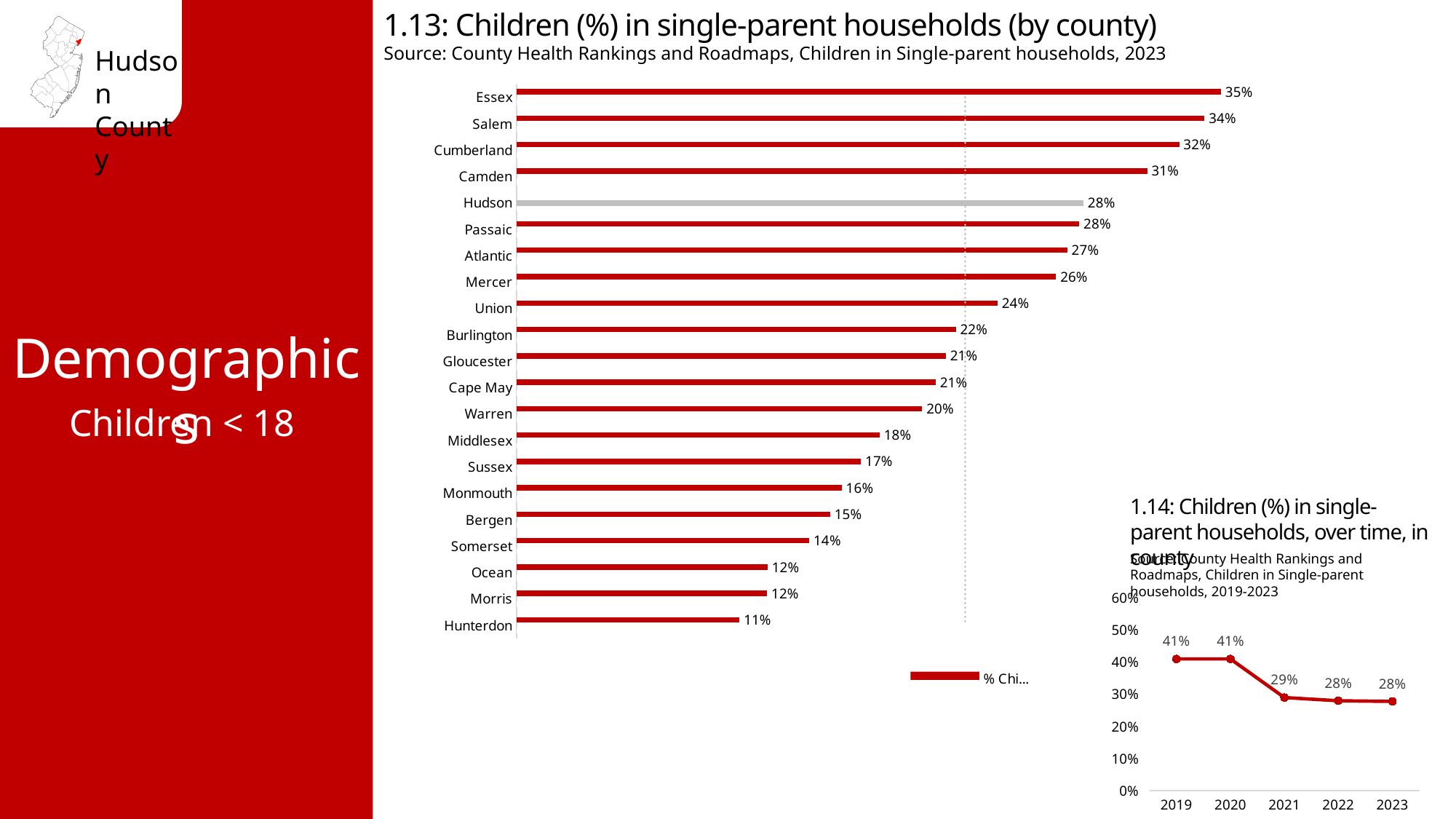
In chart 1.13 (Children (%) in single-parent households by county), what is the value for Hudson? 28% In chart 1.14 (Children (%) in single-parent households over time), what is the value for 2019? 41% In chart 1.13, what is the difference between the values for Essex and Hudson? 7 percentage points In chart 1.13, what is the value for Middlesex? 18% In chart 1.13, which county has the lowest percentage of children in single-parent households? Hunterdon In chart 1.13, how many counties are shown? 21 In chart 1.13, which county has a larger value, Camden or Mercer? Camden What kind of chart is chart 1.13? Bar chart In chart 1.14, what is the difference between the values for 2020 and 2021? 12 percentage points In chart 1.13, which county has the highest percentage of children in single-parent households? Essex In chart 1.14, do the values rise or fall from 2019 to 2023? Fall In chart 1.14, how many years are plotted? 5